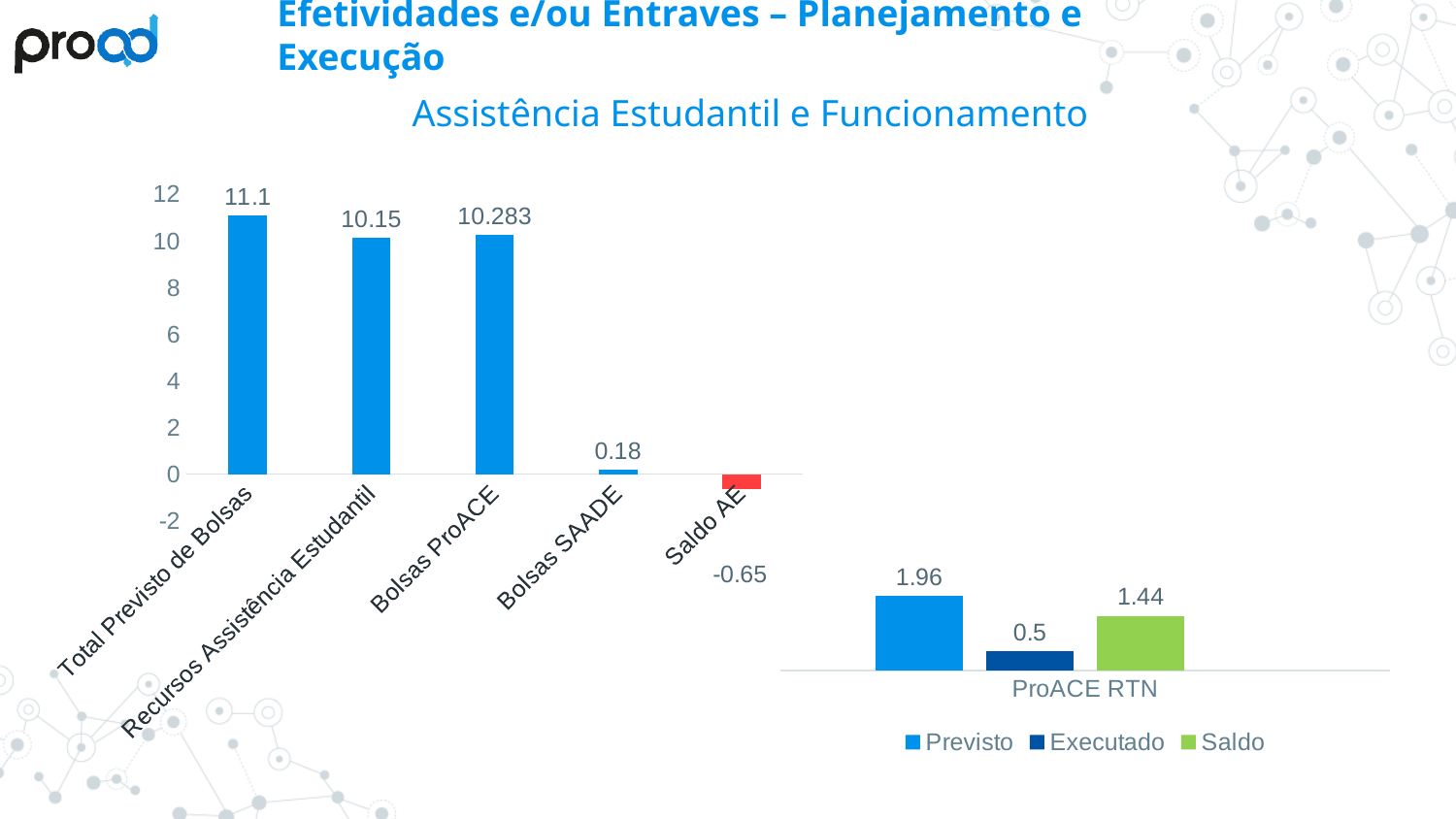
In the left chart, is the value for Bolsas SAADE greater or less than 2? less In the left chart, what is the difference between Total Previsto de Bolsas and Recursos Assistência Estudantil? 0.95 In the left chart, how many categories are shown on the x axis? 5 In the right chart (ProACE RTN), how many series does the legend list? 3 In the left chart, what is the value for Saldo AE? -0.65 In the right chart (ProACE RTN), which is larger, Previsto or Saldo? Previsto In the left chart, what is the value for Bolsas ProACE? 10.283 In the right chart (ProACE RTN), what is the value for Executado? 0.5 What kind of chart is the left chart? Bar chart In the left chart, what is the value for Total Previsto de Bolsas? 11.1 In the left chart, which category has the lowest value? Saldo AE In the left chart, which category has the highest value? Total Previsto de Bolsas